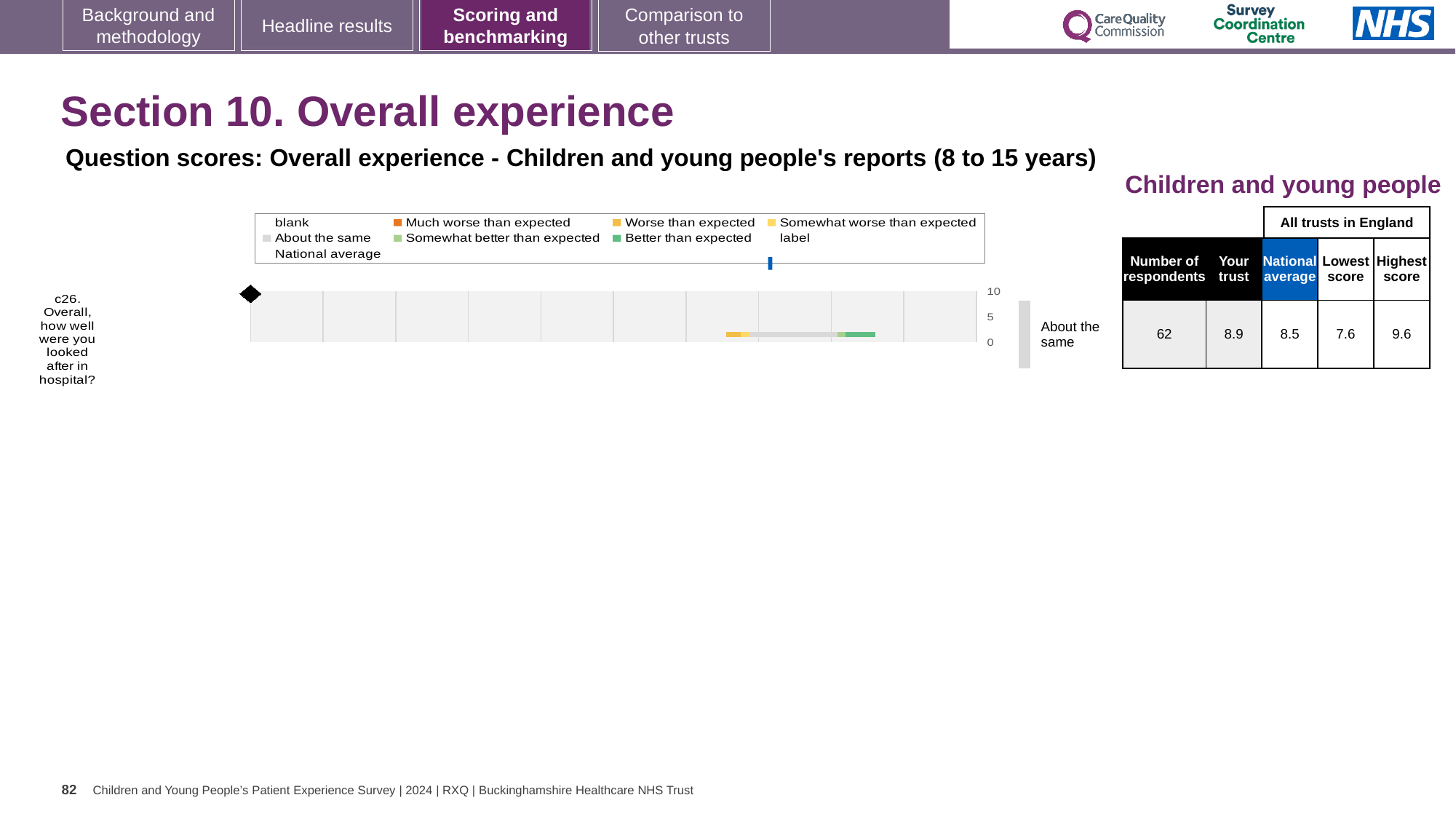
In the table beside the chart, what is the 'Your trust' score for c26? 8.9 What is the difference between the highest score and the lowest score for c26 in the table beside the chart? 2.0 Which is larger for c26, the 'Your trust' score or the national average? Your trust Which legend entry is shown in orange? Much worse than expected In the table beside the chart, what is the highest score among all trusts in England for c26? 9.6 How many questions are plotted in the chart? 1 What is the highest value shown on the chart's axis? 10 In the table beside the chart, what is the lowest score among all trusts in England for c26? 7.6 What benchmark category is shown next to the chart for question c26? About the same In the table beside the chart, how many respondents answered c26? 62 What kind of chart is shown for question c26? bar chart In the table beside the chart, what is the national average score for c26? 8.5